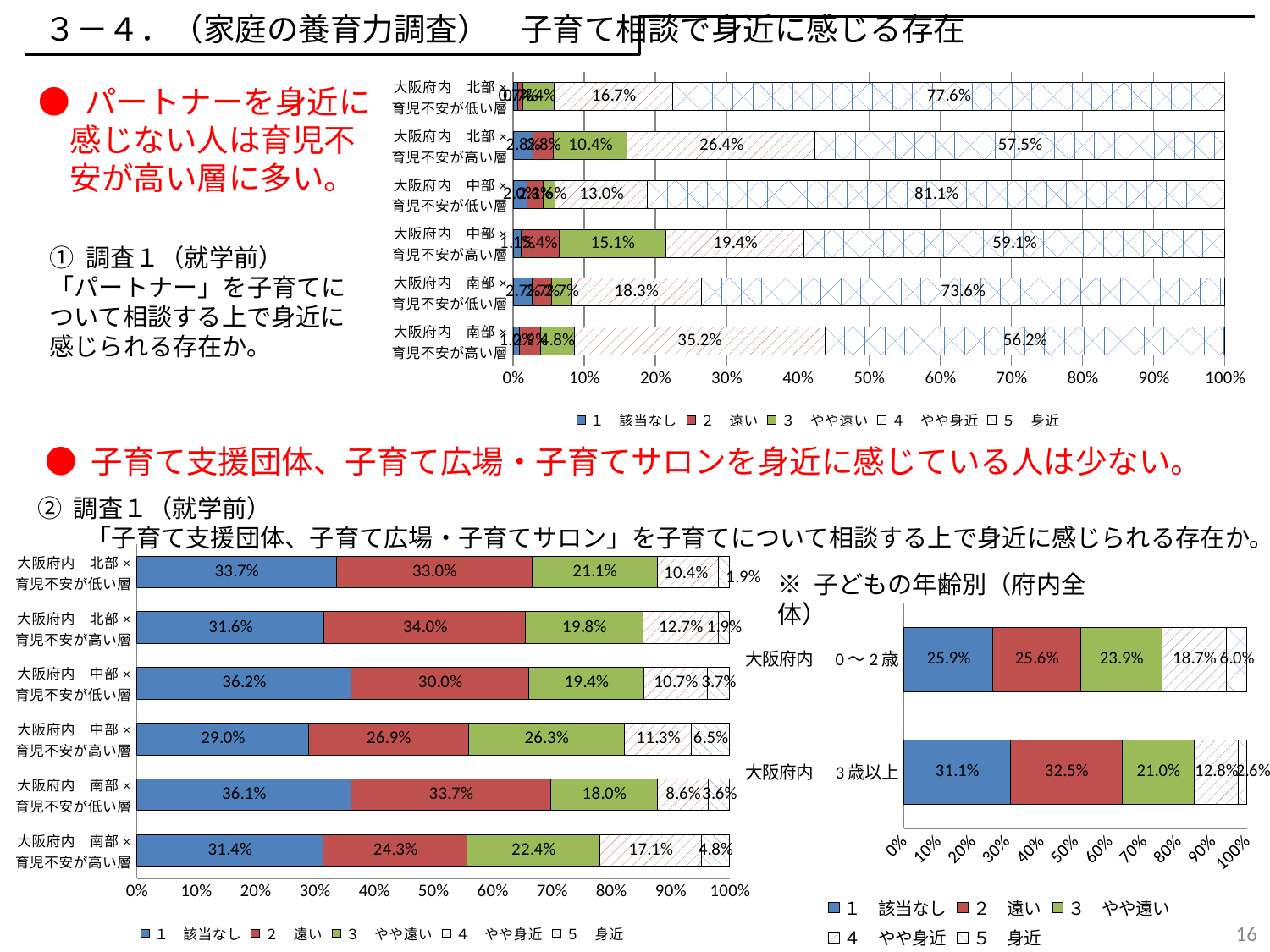
In the top-right chart (パートナー), what is the value of the 5 身近 series for 大阪府内 中部×育児不安が低い層? 81.1% How many categories are shown in the bottom-left chart (子育て支援団体)? 6 In the top-right chart (パートナー), what is the difference between the 5 身近 values for 大阪府内 北部×育児不安が低い層 and 大阪府内 北部×育児不安が高い層? 20.1% In the bottom-left chart (子育て支援団体), which is larger, the 2 遠い value for 大阪府内 北部×育児不安が高い層 or for 大阪府内 南部×育児不安が高い層? 大阪府内 北部×育児不安が高い層 In the bottom-right chart (子どもの年齢別), what is the difference between the 2 遠い values for 大阪府内 3歳以上 and 大阪府内 0〜2歳? 6.9% In the top-right chart (パートナー), what is the value of the 4 やや身近 series for 大阪府内 南部×育児不安が高い層? 35.2% How many series does the legend of the bottom-right chart (子どもの年齢別) list? 5 In the bottom-left chart (子育て支援団体), which category has the highest value for the 5 身近 series? 大阪府内 中部×育児不安が高い層 In the top-right chart (パートナー), which category has the highest value for the 5 身近 series? 大阪府内 中部×育児不安が低い層 In the bottom-left chart (子育て支援団体), what is the value of the 1 該当なし series for 大阪府内 中部×育児不安が高い層? 29.0% In the top-right chart (パートナー), which category has the lowest value for the 5 身近 series? 大阪府内 南部×育児不安が高い層 In the bottom-right chart (子どもの年齢別), what is the value of the 4 やや身近 series for 大阪府内 0〜2歳? 18.7%